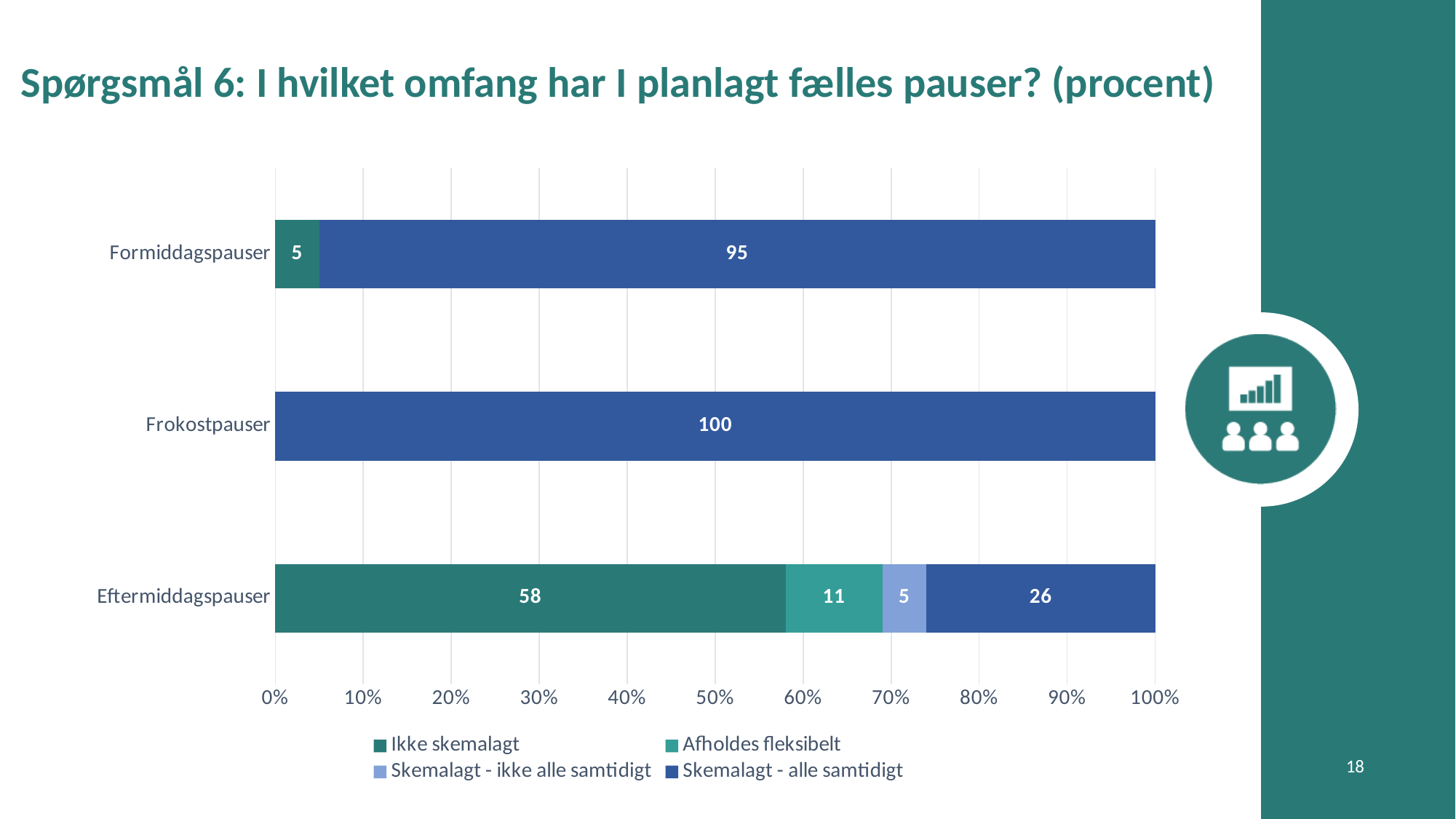
How many series does the legend list? 4 What is the value for 'Ikke skemalagt' for Eftermiddagspauser? 58 What kind of chart is shown on the slide? Stacked bar chart Which category has the highest value for 'Skemalagt - alle samtidigt'? Frokostpauser What is the title of the chart? Spørgsmål 6: I hvilket omfang har I planlagt fælles pauser? (procent) What is the value for 'Afholdes fleksibelt' for Eftermiddagspauser? 11 What is the value for 'Skemalagt - alle samtidigt' for Frokostpauser? 100 What is the value for 'Skemalagt - alle samtidigt' for Formiddagspauser? 95 Which category has the lowest value for 'Skemalagt - alle samtidigt'? Eftermiddagspauser Which is larger for Eftermiddagspauser: 'Afholdes fleksibelt' or 'Skemalagt - ikke alle samtidigt'? Afholdes fleksibelt How many categories are shown on the vertical axis? 3 What is the difference between the 'Ikke skemalagt' value for Eftermiddagspauser and the 'Skemalagt - alle samtidigt' value for Eftermiddagspauser? 32